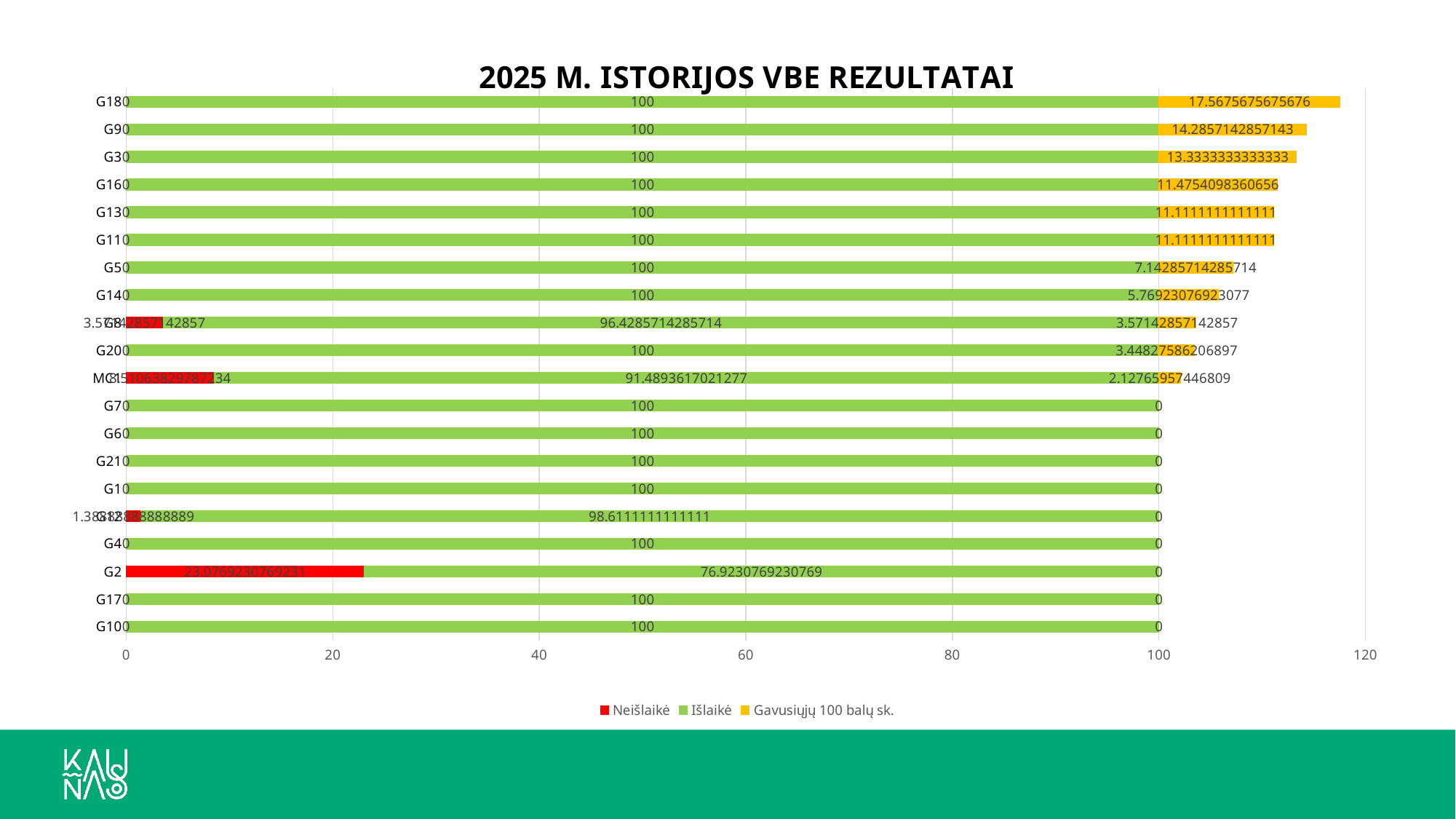
What is the Gavusiųjų 100 balų sk. value for G160? 11.4754098360656 What is the Gavusiųjų 100 balų sk. value for G180? 17.5675675675676 What is the total of the stacked bar for G2? 100 How many series does the legend list? 3 What kind of chart is shown on the slide? bar chart How many categories (bars) are plotted in the chart? 20 What is the Išlaikė value for G2? 76.9230769230769 What is the title of the chart? 2025 M. ISTORIJOS VBE REZULTATAI What is the Neišlaikė value for G2? 23.0769230769231 Which category has the lowest Išlaikė value? G2 Which has the larger Gavusiųjų 100 balų sk. value, G90 or G30? G90 Which category has the highest Gavusiųjų 100 balų sk. value? G180